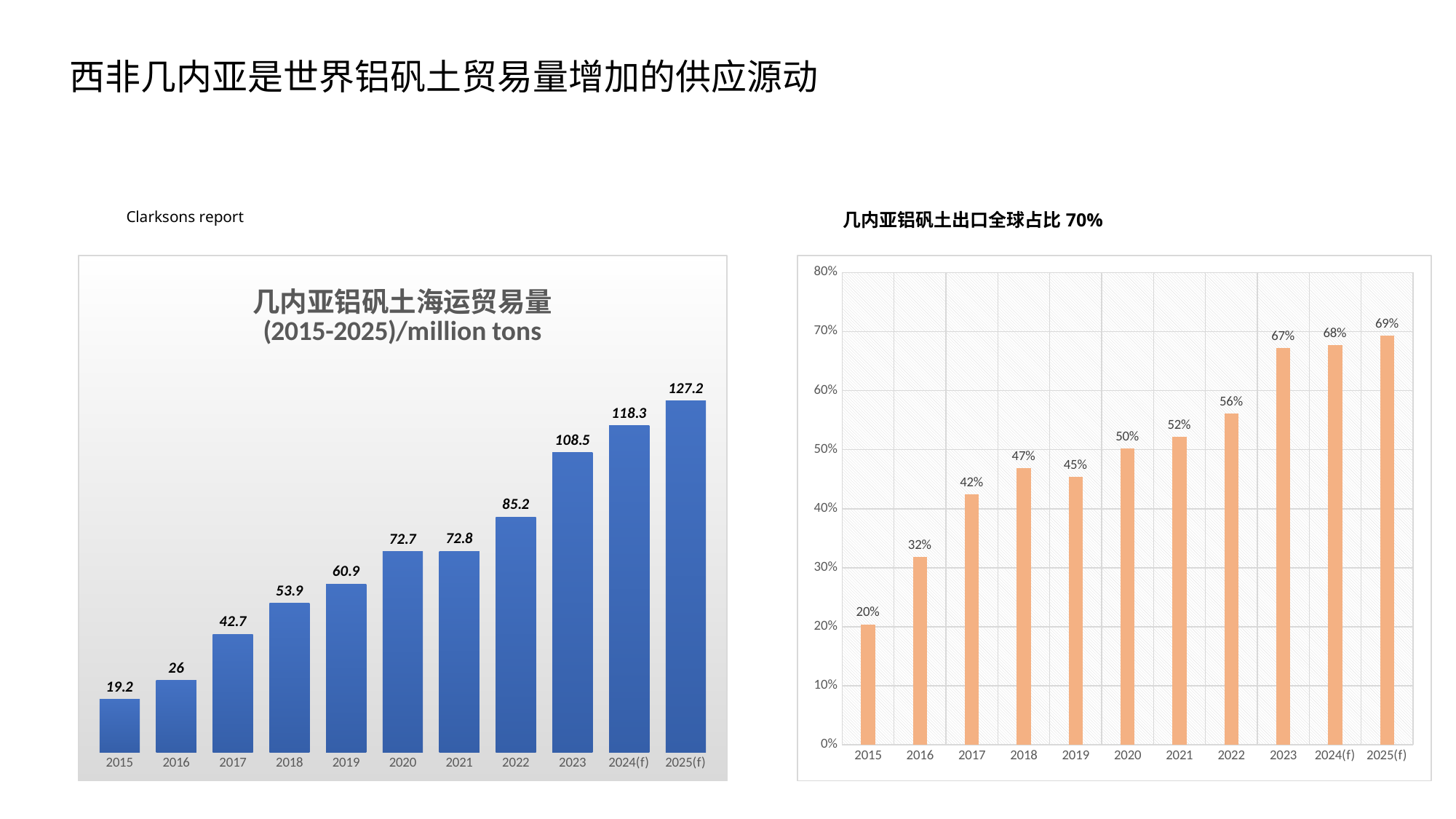
In the left chart (几内亚铝矾土海运贸易量), what is the difference between the 2023 value and the 2022 value? 23.3 In the right chart (几内亚铝矾土出口全球占比), what is the difference between the 2016 value and the 2015 value? 12% In the right chart (几内亚铝矾土出口全球占比), which is larger, the value for 2018 or the value for 2019? 2018 In the left chart (几内亚铝矾土海运贸易量), do the values generally rise or fall from 2015 to 2025(f)? rise In the right chart (几内亚铝矾土出口全球占比), what is the value for 2020? 50% In the left chart (几内亚铝矾土海运贸易量), which year has the lowest value? 2015 In the right chart (几内亚铝矾土出口全球占比), which year has the highest value? 2025(f) What is the title of the left chart? 几内亚铝矾土海运贸易量(2015-2025)/million tons In the left chart (几内亚铝矾土海运贸易量), what is the value for 2025(f)? 127.2 In the left chart (几内亚铝矾土海运贸易量), what is the value for 2018? 53.9 What type of chart is the right chart (几内亚铝矾土出口全球占比)? bar chart In the left chart (几内亚铝矾土海运贸易量), how many bars are plotted? 11